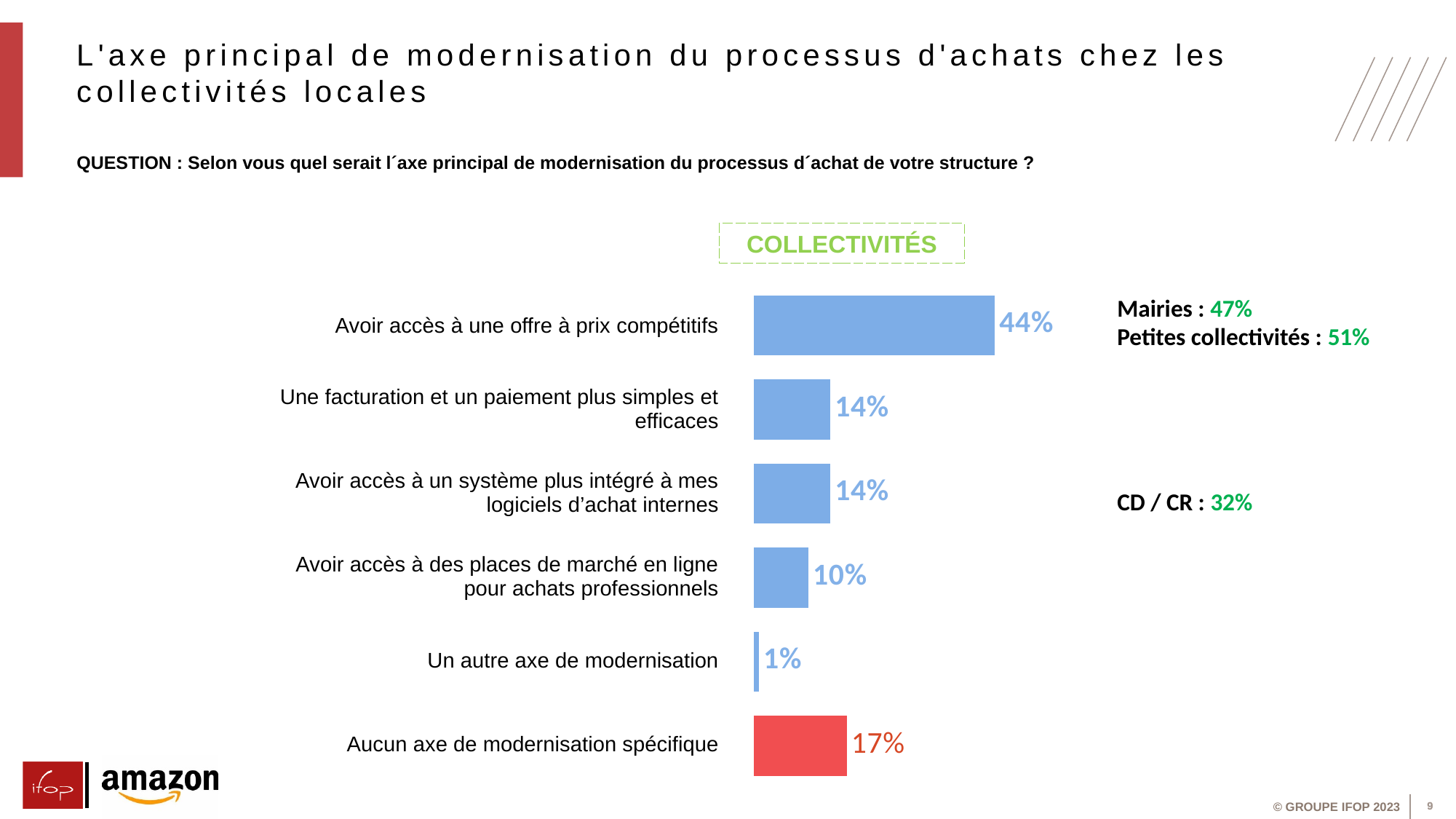
Which bar is coloured red rather than blue? Aucun axe de modernisation spécifique What is the value for "Mairies" shown next to the chart? 47% What is the value for "Un autre axe de modernisation"? 1% How many categories are shown in the chart? 6 Which is larger: "Une facturation et un paiement plus simples et efficaces" or "Avoir accès à des places de marché en ligne pour achats professionnels"? Une facturation et un paiement plus simples et efficaces Which category has the highest value? Avoir accès à une offre à prix compétitifs What kind of chart is shown on the slide? Bar chart What is the value for "Avoir accès à des places de marché en ligne pour achats professionnels"? 10% What percentage of respondents chose "Avoir accès à une offre à prix compétitifs"? 44% What is the value for "Aucun axe de modernisation spécifique"? 17% What is the difference between "Avoir accès à une offre à prix compétitifs" and "Aucun axe de modernisation spécifique"? 27% Which category has the lowest value? Un autre axe de modernisation